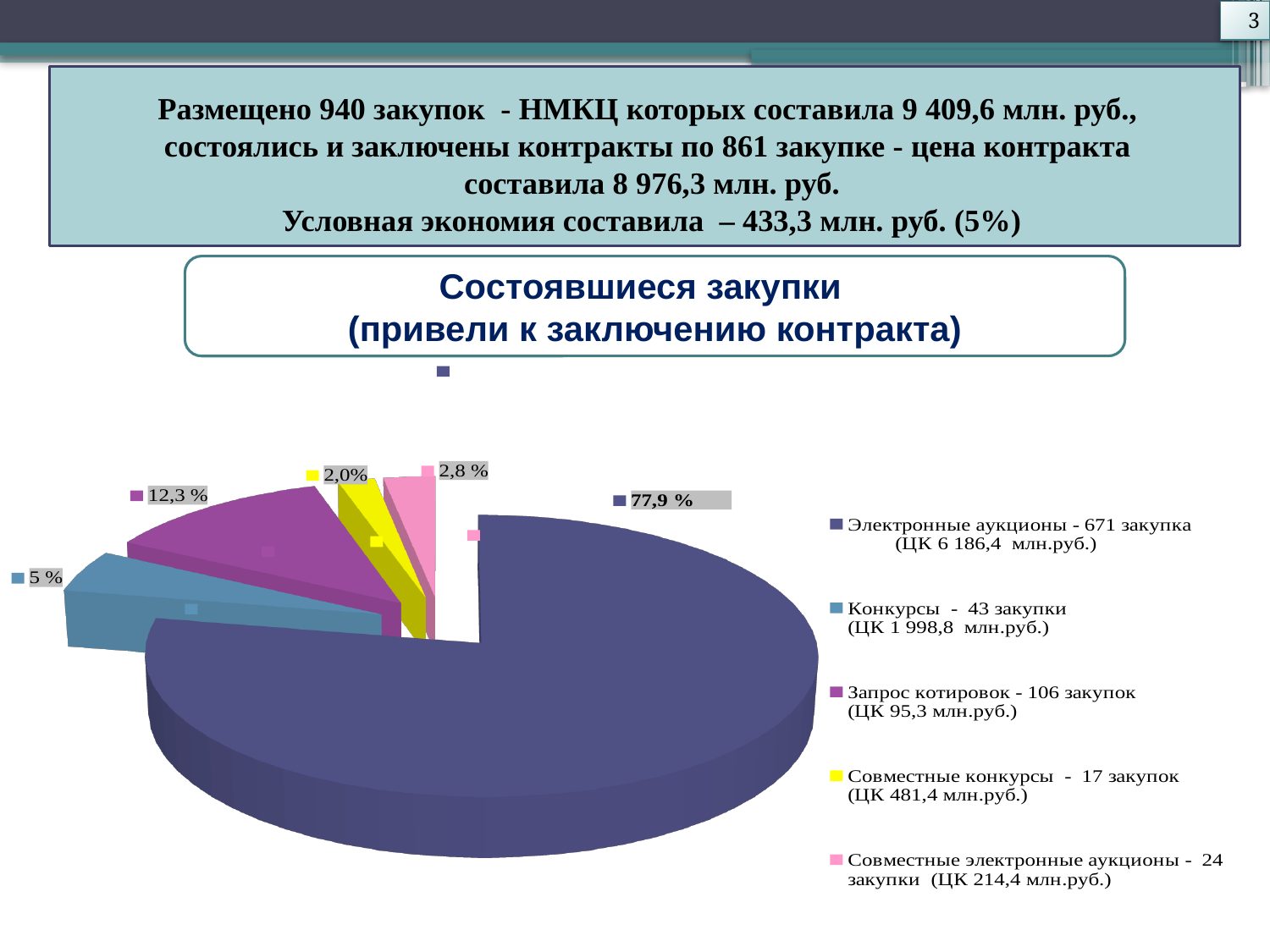
How many slices does the pie chart have? 5 What share of the pie does Совместные электронные аукционы have? 2,8 % What kind of chart is shown on the slide? pie chart What share of the pie does Запрос котировок have? 12,3 % Which category has the largest slice of the pie? Электронные аукционы What is the title shown above the pie chart? Состоявшиеся закупки (привели к заключению контракта) Which category has the smallest slice of the pie? Совместные конкурсы What is the difference in percentage points between the Электронные аукционы slice and the Запрос котировок slice? 65,6 What share of the pie does Совместные конкурсы have? 2,0% What share of the pie does Электронные аукционы have? 77,9 % Which slice is larger: Запрос котировок or Конкурсы? Запрос котировок What share of the pie does Конкурсы have? 5 %